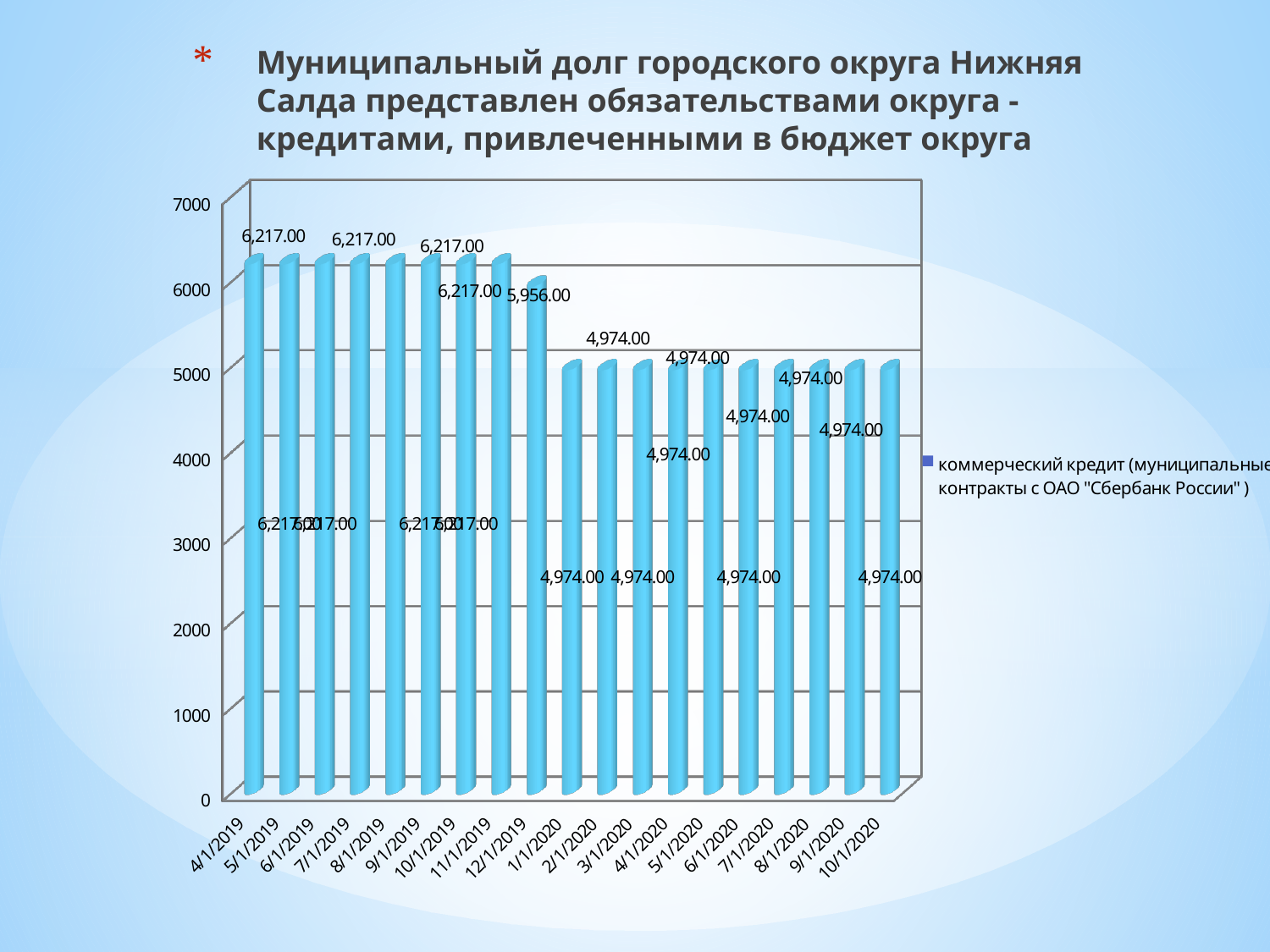
What kind of chart is shown on the slide? bar chart What is the difference between the value for 4/1/2019 and the value for 10/1/2020? 1,243.00 How many dates are shown on the x axis? 19 How many series does the legend list? 1 What is the value for 10/1/2020? 4,974.00 Is the value for 12/1/2019 greater or less than 6000? less What is the value for 12/1/2019? 5,956.00 Which is larger, the value for 12/1/2019 or the value for 1/1/2020? 12/1/2019 What is the difference between the value for 11/1/2019 and the value for 12/1/2019? 261.00 Do the values rise or fall from 4/1/2019 to 10/1/2020? fall What is the value for 4/1/2019? 6,217.00 What is the value for 11/1/2019? 6,217.00